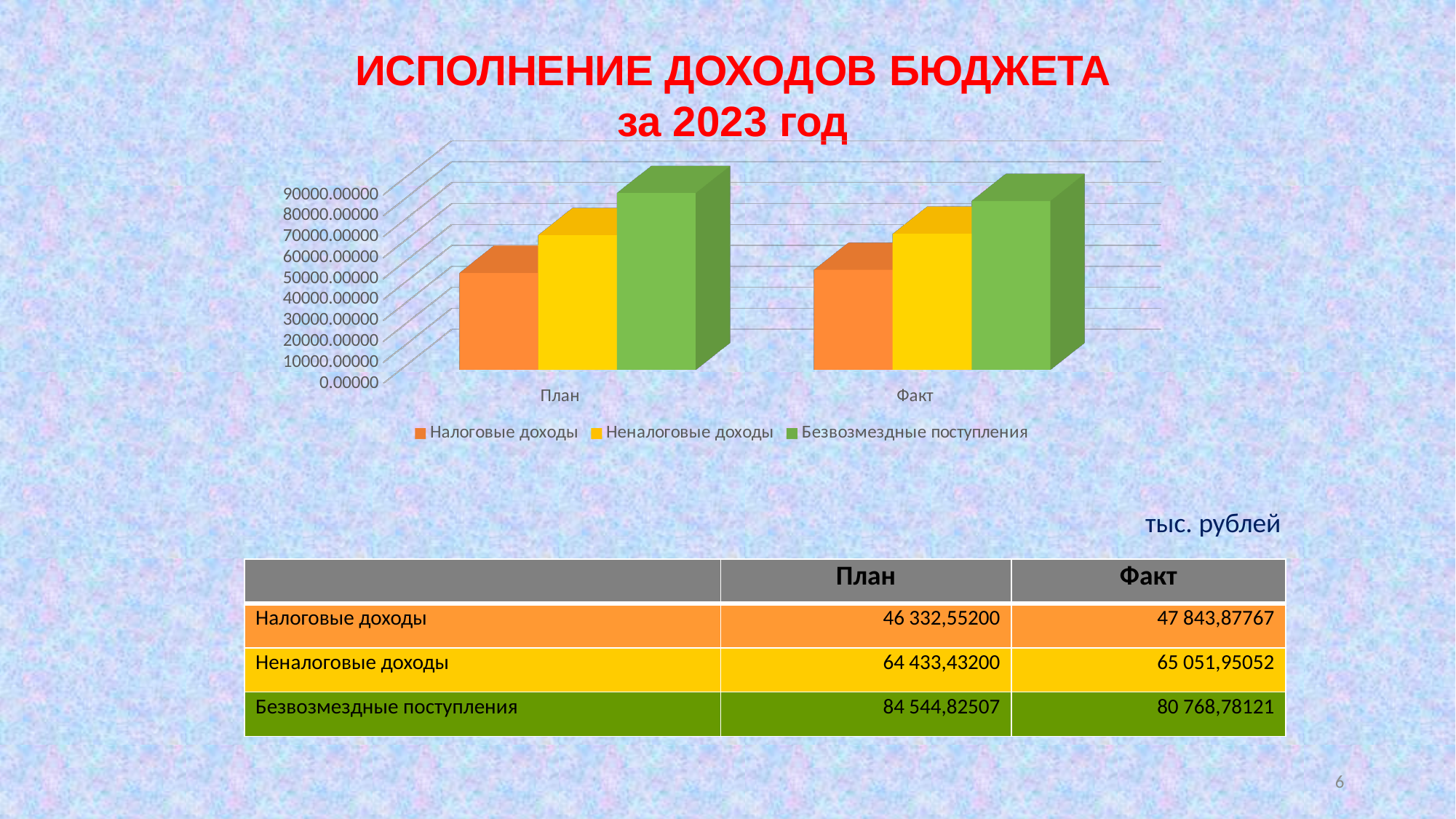
Is the value for Налоговые доходы in the План category greater or less than 60000.00000? less Which is larger: Безвозмездные поступления for План or Безвозмездные поступления for Факт? План What kind of chart is shown on the slide? bar chart What colour represents the Неналоговые доходы series in the chart? yellow What is the Факт value for Налоговые доходы, as printed in the table on the slide? 47 843,87767 Is the value for Безвозмездные поступления in the Факт category greater or less than 70000.00000? greater Which series has the lowest value in the Факт category? Налоговые доходы Which series has the highest value in the План category? Безвозмездные поступления How many categories are shown on the x axis of the chart? 2 How many series does the chart legend list? 3 What is the Факт value for Безвозмездные поступления, as printed in the table on the slide? 80 768,78121 What is the План value for Неналоговые доходы, as printed in the table on the slide? 64 433,43200